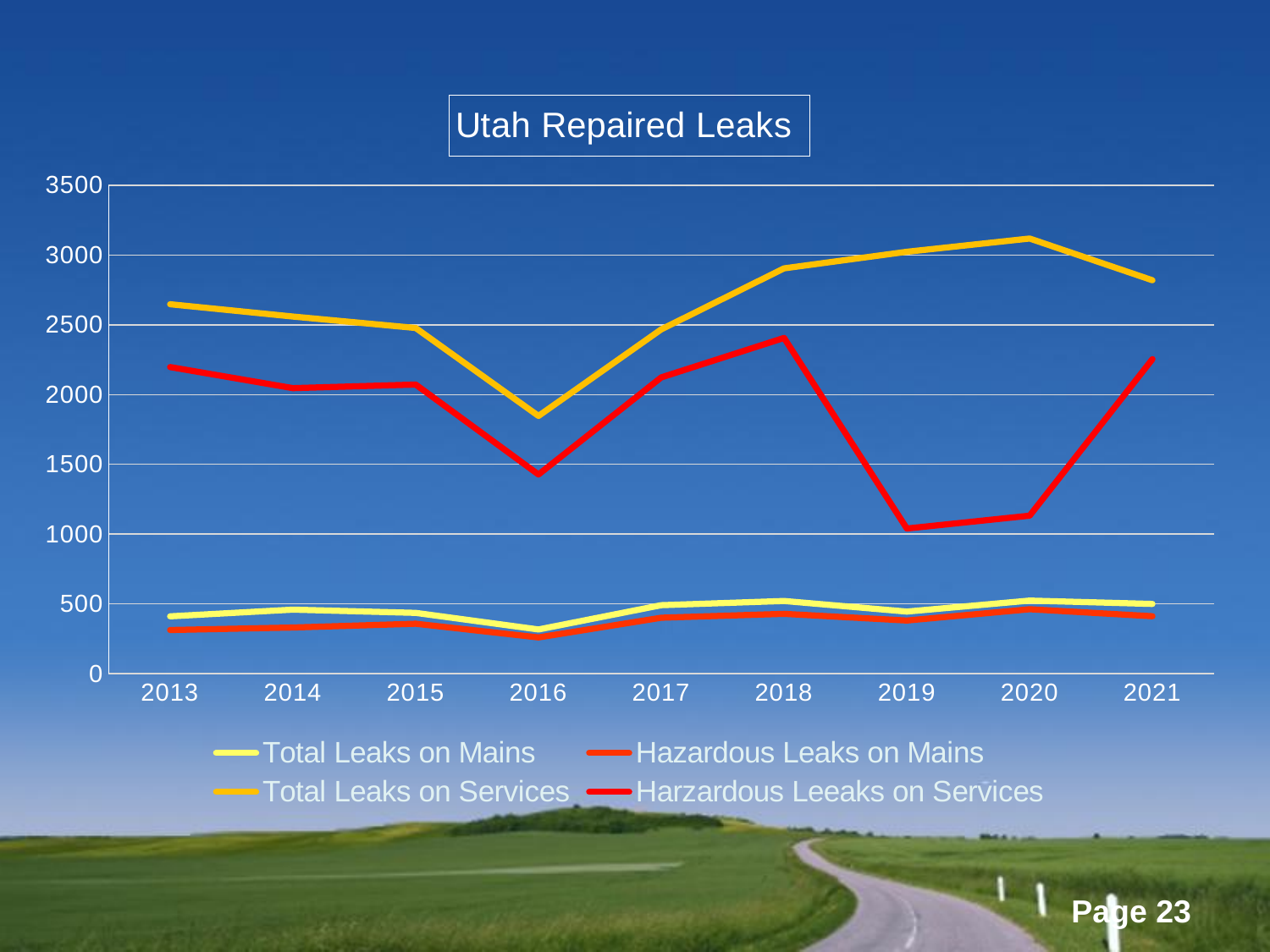
Does the Total Leaks on Services series rise or fall from 2016 to 2020? rise In 2013, which is larger: Total Leaks on Services or Harzardous Leeaks on Services? Total Leaks on Services How many years are plotted along the x axis? 9 Is the value for Harzardous Leeaks on Services in 2019 greater or less than 1500? less In which year does the Total Leaks on Services series reach its lowest value? 2016 Is the value for Total Leaks on Services in 2020 greater or less than 3000? greater In which year does the Total Leaks on Services series reach its highest value? 2020 How many series does the legend list? 4 Is the value for Total Leaks on Services in 2016 greater or less than 2000? less What is the title of the chart? Utah Repaired Leaks What kind of chart is shown on the slide? line chart In which year does the Harzardous Leeaks on Services series reach its lowest value? 2019